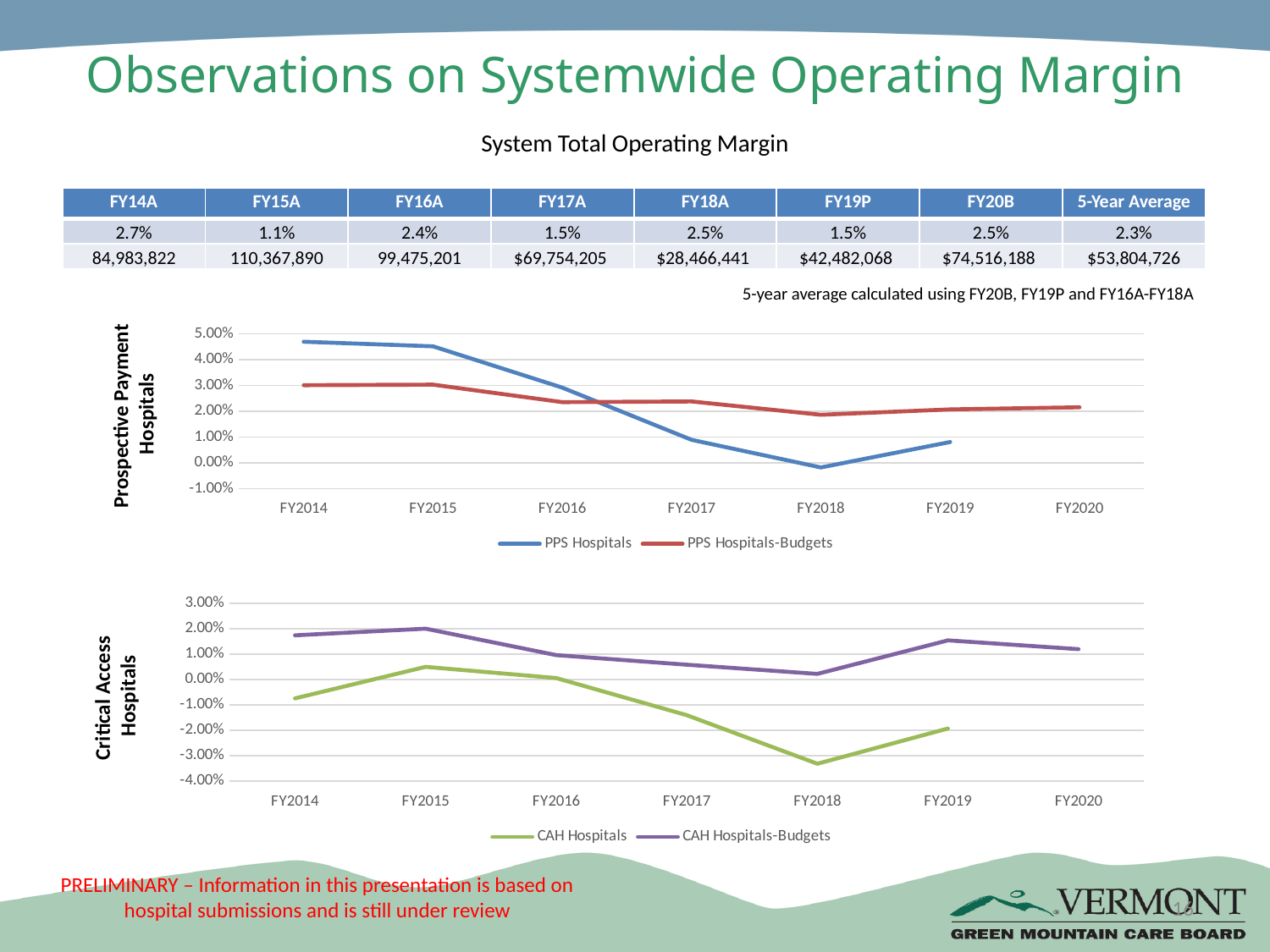
In the Critical Access Hospitals chart, is the value for CAH Hospitals-Budgets in FY2015 greater or less than 1.00%? greater In the Prospective Payment Hospitals chart, which series has the higher value in FY2014, PPS Hospitals or PPS Hospitals-Budgets? PPS Hospitals In the Prospective Payment Hospitals chart, is the value for PPS Hospitals in FY2016 greater or less than 2.00%? greater What kind of chart is the Prospective Payment Hospitals chart? Line chart In the Critical Access Hospitals chart, in which fiscal year is the CAH Hospitals line at its highest? FY2015 In the Critical Access Hospitals chart, which series has the higher value in FY2018, CAH Hospitals or CAH Hospitals-Budgets? CAH Hospitals-Budgets In the Prospective Payment Hospitals chart, is the value for PPS Hospitals in FY2014 greater or less than 4.00%? greater In the Prospective Payment Hospitals chart, in which fiscal year is the PPS Hospitals line at its lowest? FY2018 How many fiscal years are shown on the x axis of the Prospective Payment Hospitals chart? 7 In the Prospective Payment Hospitals chart, does the PPS Hospitals line rise or fall from FY2014 to FY2018? Fall How many series does the legend of the Critical Access Hospitals chart list? 2